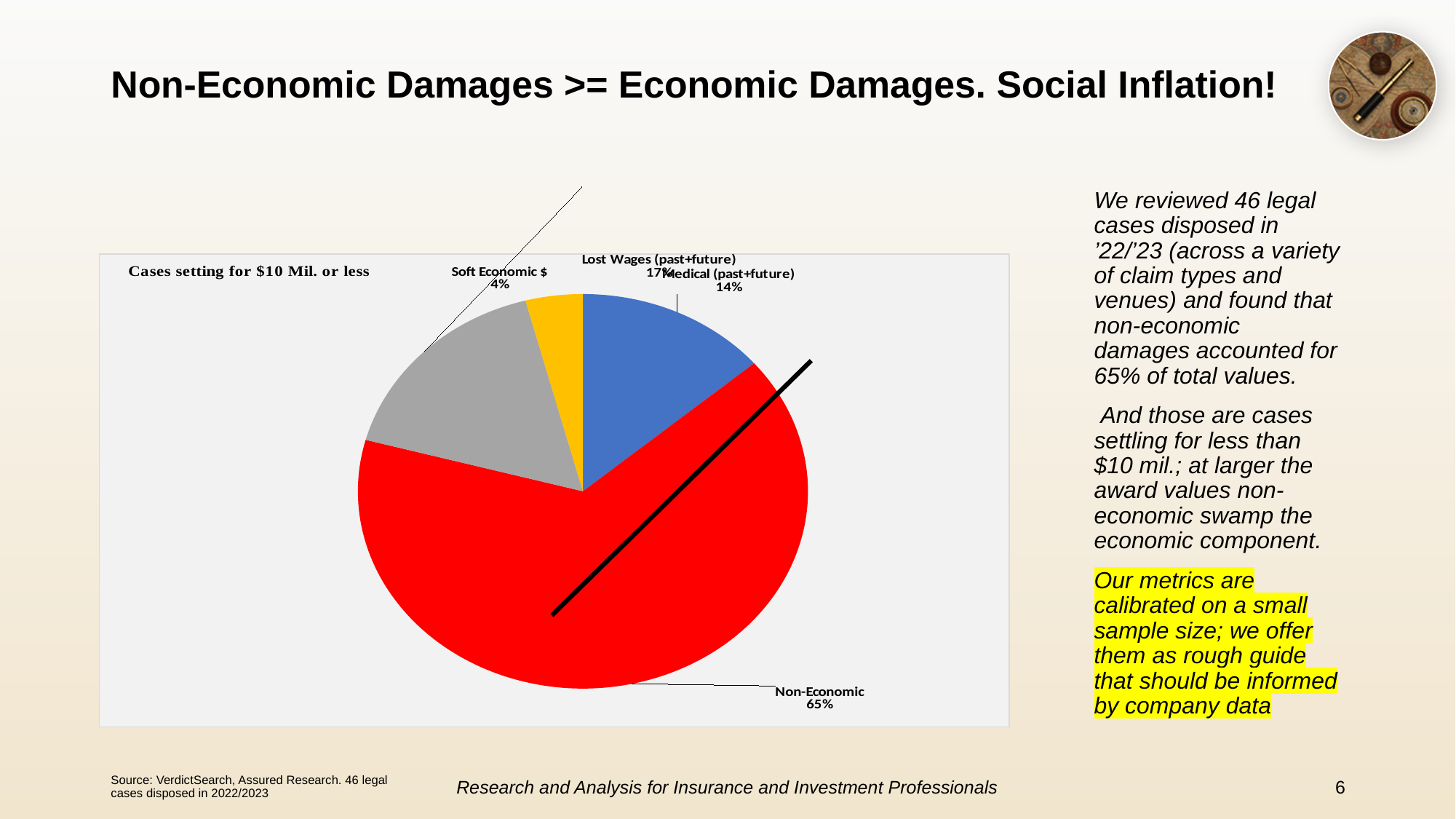
How many slices does the pie chart have? 4 What is the difference in percentage points between the Non-Economic slice and the Medical (past+future) slice? 51 Which slice of the pie is the largest? Non-Economic What colour is the Non-Economic slice of the pie? Red What kind of chart is shown on the slide? Pie chart What share of the pie does Soft Economic $ account for? 4% What is the title of the pie chart? Cases setting for $10 Mil. or less What share of the pie does Medical (past+future) account for? 14% Which is larger, the Lost Wages (past+future) slice or the Medical (past+future) slice? Lost Wages (past+future) Which slice of the pie is the smallest? Soft Economic $ What share of the pie does Non-Economic account for? 65%